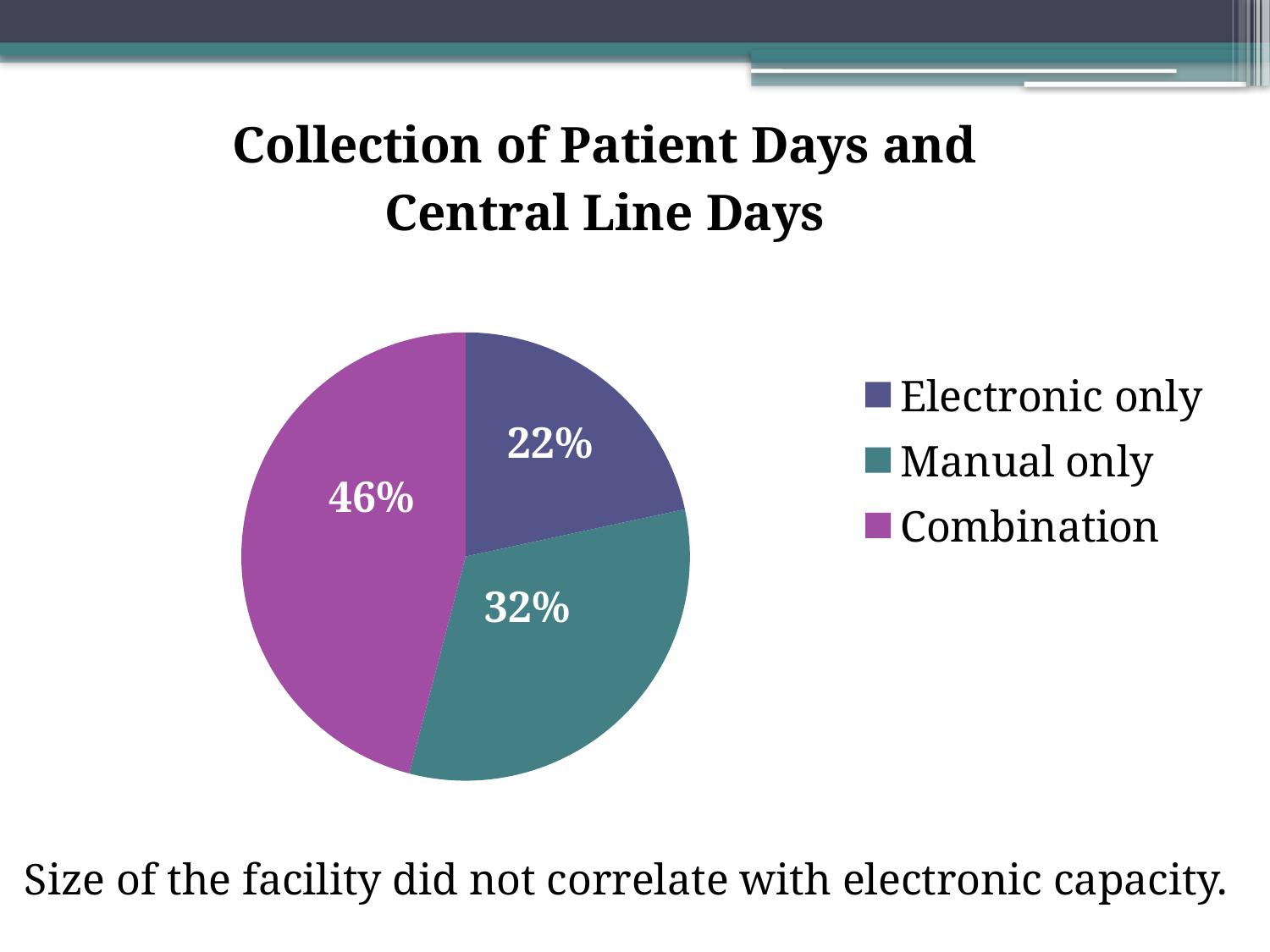
What colour is the Combination slice in the pie chart? purple What is the difference in percentage points between Manual only and Electronic only? 10 What share of the pie is Electronic only? 22% What kind of chart is shown on the slide? pie chart Which category has the largest share of the pie? Combination What share of the pie is Manual only? 32% What share of the pie is Combination? 46% Which is larger, the share for Manual only or the share for Electronic only? Manual only What is the difference in percentage points between Combination and Electronic only? 24 What is the title of the chart? Collection of Patient Days and Central Line Days How many slices does the pie chart have? 3 Which category has the smallest share of the pie? Electronic only